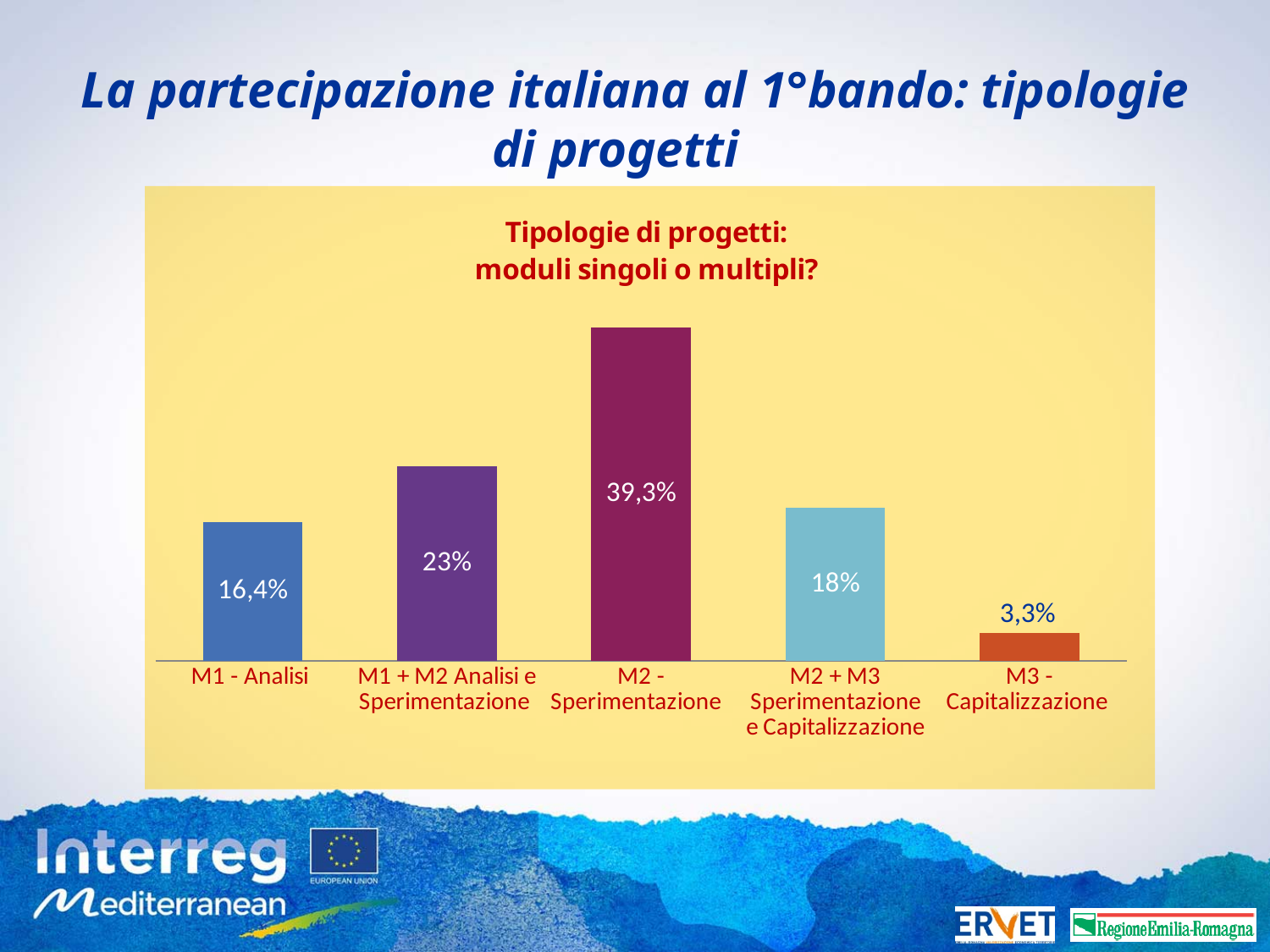
How many categories are shown in the chart? 5 Which is larger, the value for M1 + M2 Analisi e Sperimentazione or the value for M2 + M3 Sperimentazione e Capitalizzazione? M1 + M2 Analisi e Sperimentazione Which category has the lowest value? M3 - Capitalizzazione What is the value for M1 - Analisi? 16,4% Which category has the highest value? M2 - Sperimentazione What is the title of the chart? Tipologie di progetti: moduli singoli o multipli? What is the value for M2 - Sperimentazione? 39,3% What is the difference between the values for M1 - Analisi and M3 - Capitalizzazione? 13,1% What kind of chart is shown on the slide? Bar chart What is the value for M3 - Capitalizzazione? 3,3% What is the difference between the values for M2 - Sperimentazione and M1 + M2 Analisi e Sperimentazione? 16,3% What is the value for M2 + M3 Sperimentazione e Capitalizzazione? 18%